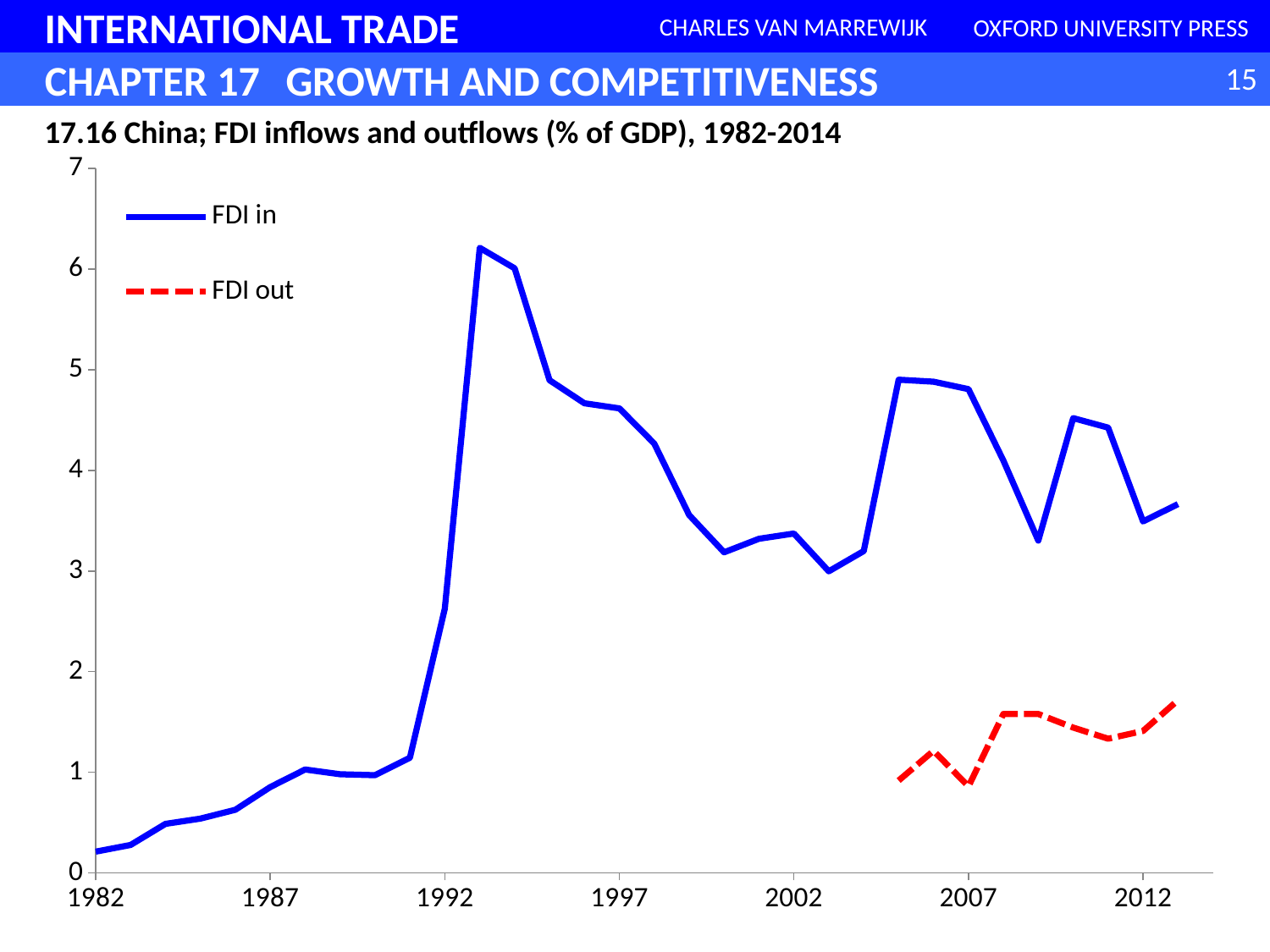
In 2012, which series has the larger value, FDI in or FDI out? FDI in Is the value for FDI out in 2012 greater or less than 2? less What is the title of the chart? 17.16 China; FDI inflows and outflows (% of GDP), 1982-2014 How many series does the legend list? 2 Is the value for FDI in in 2007 greater or less than 4? greater Is the value for FDI in in 1992 greater or less than 2? greater Which series is drawn as a red dashed line? FDI out What kind of chart is shown on the slide? line chart Does the FDI in series rise or fall between 1997 and 2002? fall Does the FDI in series rise or fall between 1982 and 1992? rise